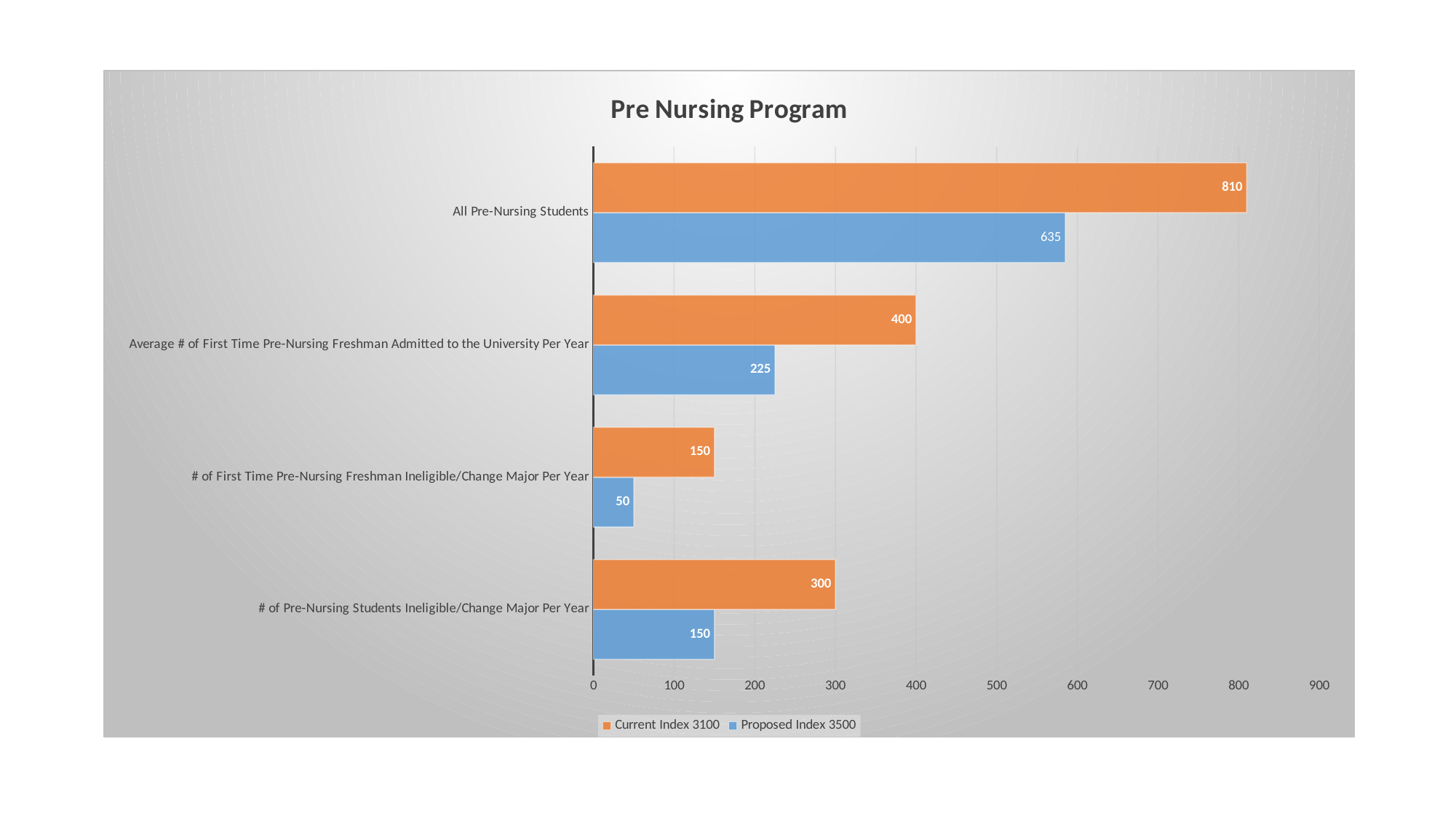
What is the Proposed Index 3500 value for Average # of First Time Pre-Nursing Freshman Admitted to the University Per Year? 225 What is the Current Index 3100 value for All Pre-Nursing Students? 810 What is the difference between the Current Index 3100 and Proposed Index 3500 values for All Pre-Nursing Students? 175 Which category has the lowest Proposed Index 3500 value? # of First Time Pre-Nursing Freshman Ineligible/Change Major Per Year What type of chart is shown on the slide? Bar chart Which is larger for Average # of First Time Pre-Nursing Freshman Admitted to the University Per Year: Current Index 3100 or Proposed Index 3500? Current Index 3100 Which category has the highest Current Index 3100 value? All Pre-Nursing Students How many series does the legend list? 2 What is the Proposed Index 3500 value for All Pre-Nursing Students? 635 How many categories are shown on the chart? 4 What is the Current Index 3100 value for # of First Time Pre-Nursing Freshman Ineligible/Change Major Per Year? 150 What is the difference between the Current Index 3100 and Proposed Index 3500 values for # of Pre-Nursing Students Ineligible/Change Major Per Year? 150